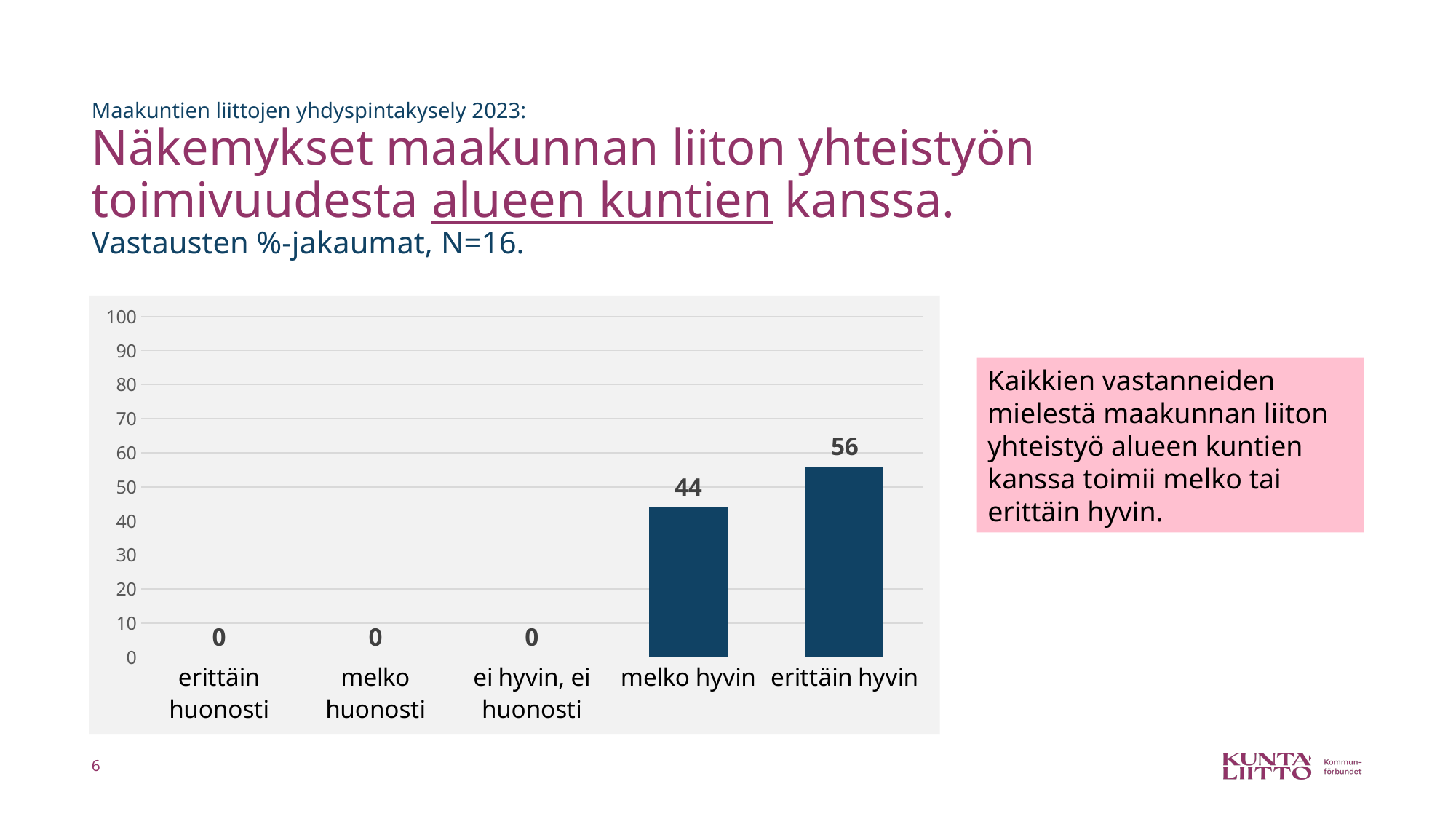
Which is larger, the value for "melko hyvin" or the value for "erittäin hyvin"? erittäin hyvin How many categories are shown on the x axis? 5 Which category has the highest value? erittäin hyvin What is the value for "erittäin hyvin"? 56 What is the difference between the values for "erittäin hyvin" and "melko hyvin"? 12 What kind of chart is shown on the slide? bar chart Is the value for "melko hyvin" greater or less than 50? less How many categories have a value of 0? 3 What is the total of the values for "melko hyvin" and "erittäin hyvin"? 100 What is the value for "melko hyvin"? 44 What is the value for "erittäin huonosti"? 0 What is the value for "ei hyvin, ei huonosti"? 0